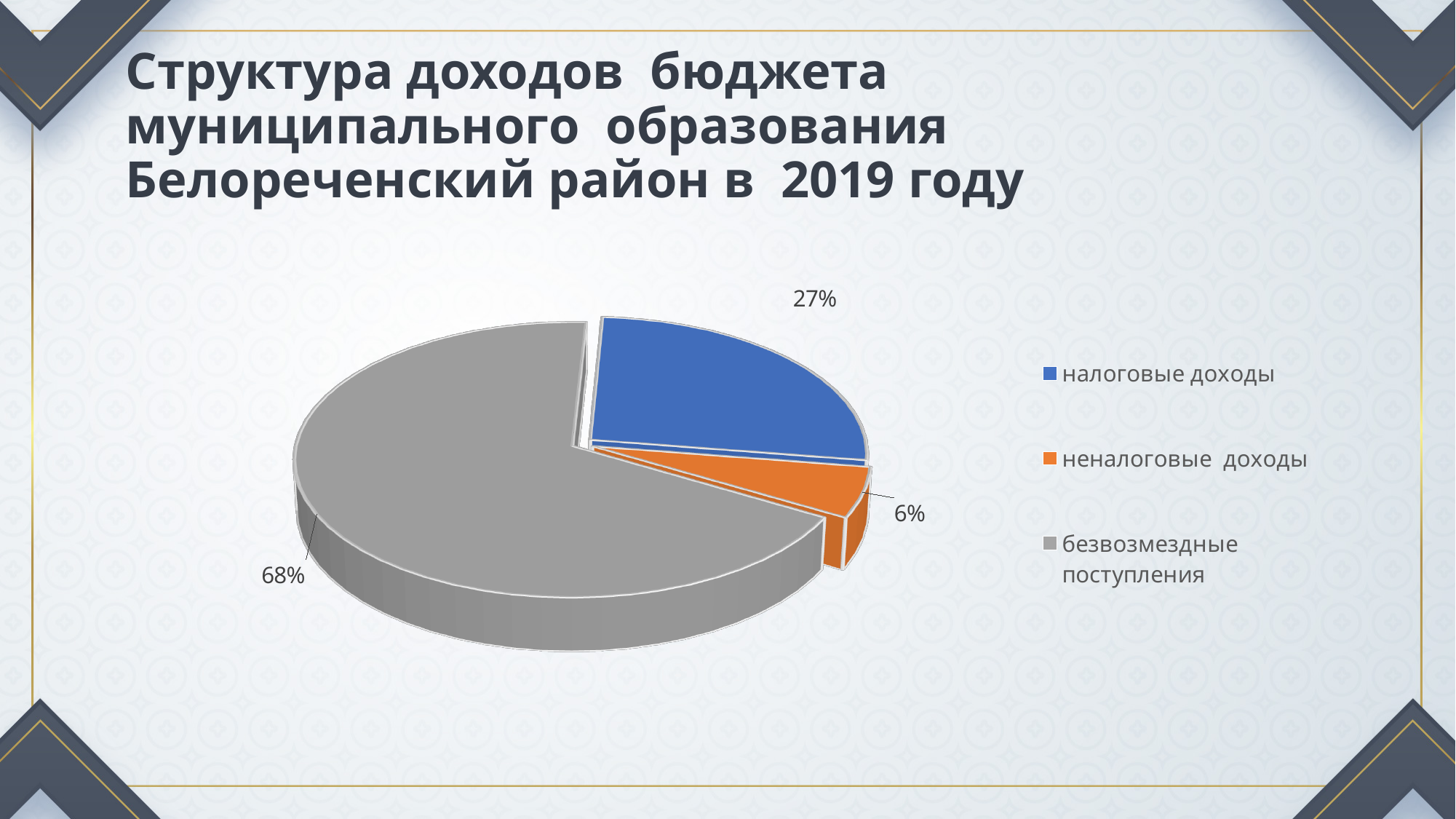
How many categories are shown in the pie chart? 3 What share of the pie does неналоговые доходы have? 6% Which year does the chart title refer to? 2019 Which category has the largest slice of the pie? безвозмездные поступления What kind of chart is shown on the slide? pie chart Which category has the smallest slice of the pie? неналоговые доходы Which is larger, налоговые доходы or неналоговые доходы? налоговые доходы What colour is the slice for безвозмездные поступления? grey What share of the pie does безвозмездные поступления have? 68% What is the difference in percentage points between безвозмездные поступления and налоговые доходы? 41 What is the difference in percentage points between налоговые доходы and неналоговые доходы? 21 What share of the pie does налоговые доходы have? 27%